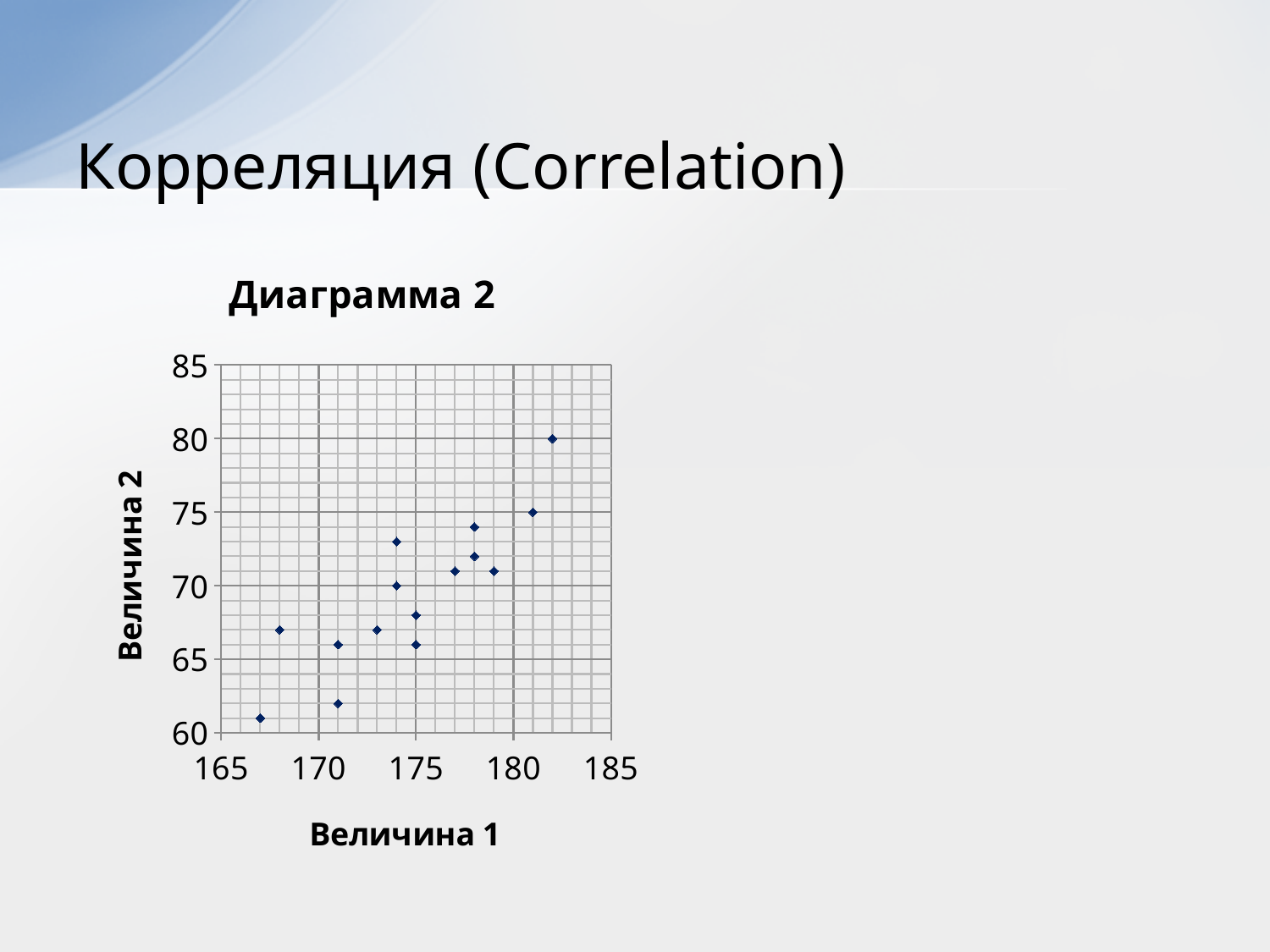
What is the highest value of Величина 2 plotted on the chart? 80 What is the label of the horizontal axis of the chart? Величина 1 How many data points are plotted on the chart? 15 Is the Величина 1 value of the highest point on the chart greater or less than 180? greater Do the values of Величина 2 generally rise or fall as Величина 1 increases? rise Which has the larger Величина 2 value: the rightmost point or the leftmost point? the rightmost point Is the Величина 2 value of the leftmost point on the chart greater or less than 65? less Is the Величина 1 value of the lowest point on the chart greater or less than 170? less What kind of chart is shown on the slide? scatter chart What is the maximum value shown on the vertical axis of the chart? 85 What is the title of the chart? Диаграмма 2